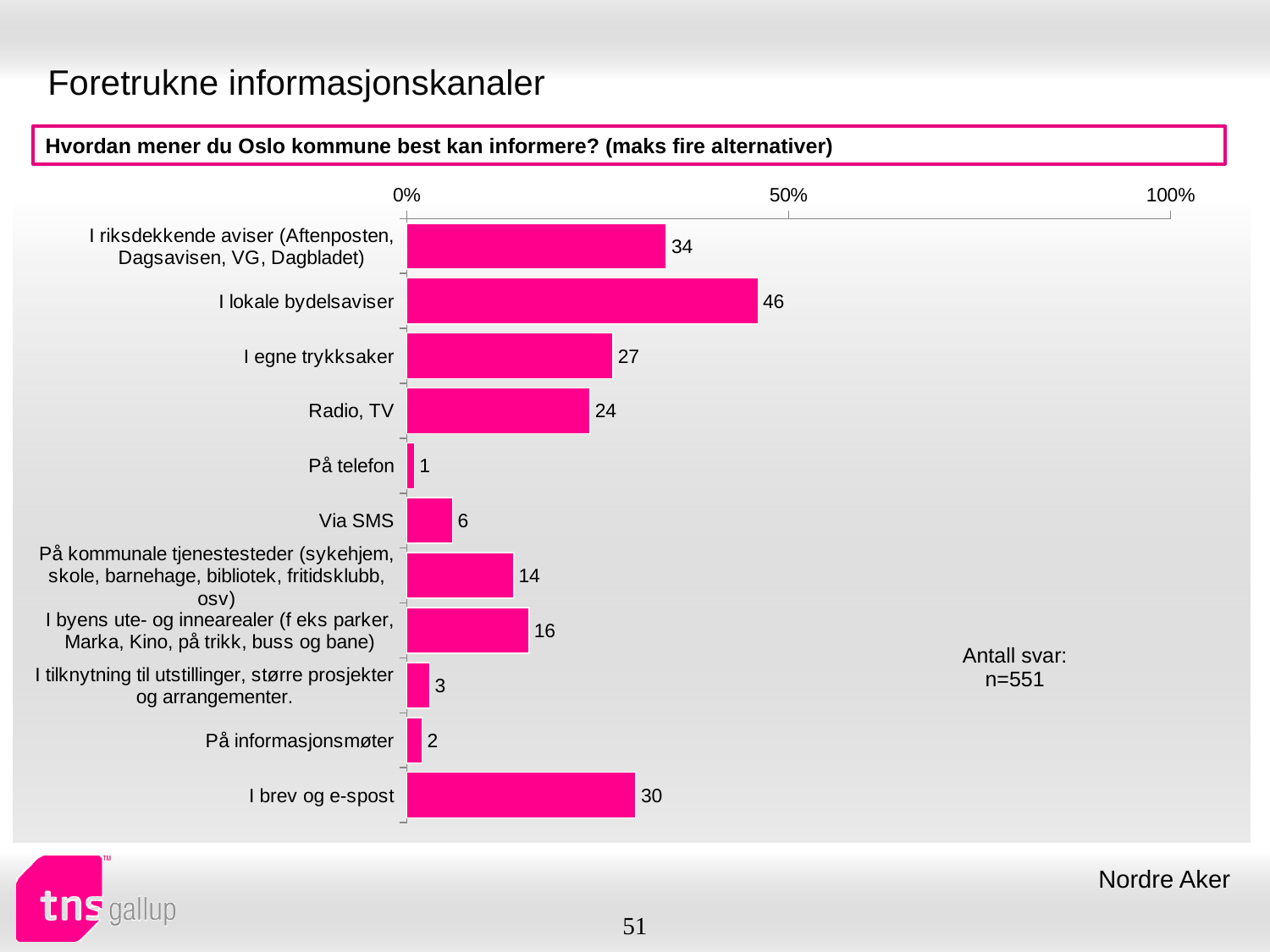
Which category has the highest value? I lokale bydelsaviser How many categories are shown in the chart? 11 Which category has the lowest value? På telefon What is the number of responses (n) stated on the slide? n=551 What is the value for "Radio, TV"? 24 What is the value for "I brev og e-spost"? 30 What is the difference between the values for "I lokale bydelsaviser" and "I riksdekkende aviser (Aftenposten, Dagsavisen, VG, Dagbladet)"? 12 Is the value for "I lokale bydelsaviser" greater or less than 50%? less What is the value for "I lokale bydelsaviser"? 46 What kind of chart is shown on the slide? bar chart Which is larger, the value for "I egne trykksaker" or the value for "I brev og e-spost"? I brev og e-spost What is the value for "Via SMS"? 6